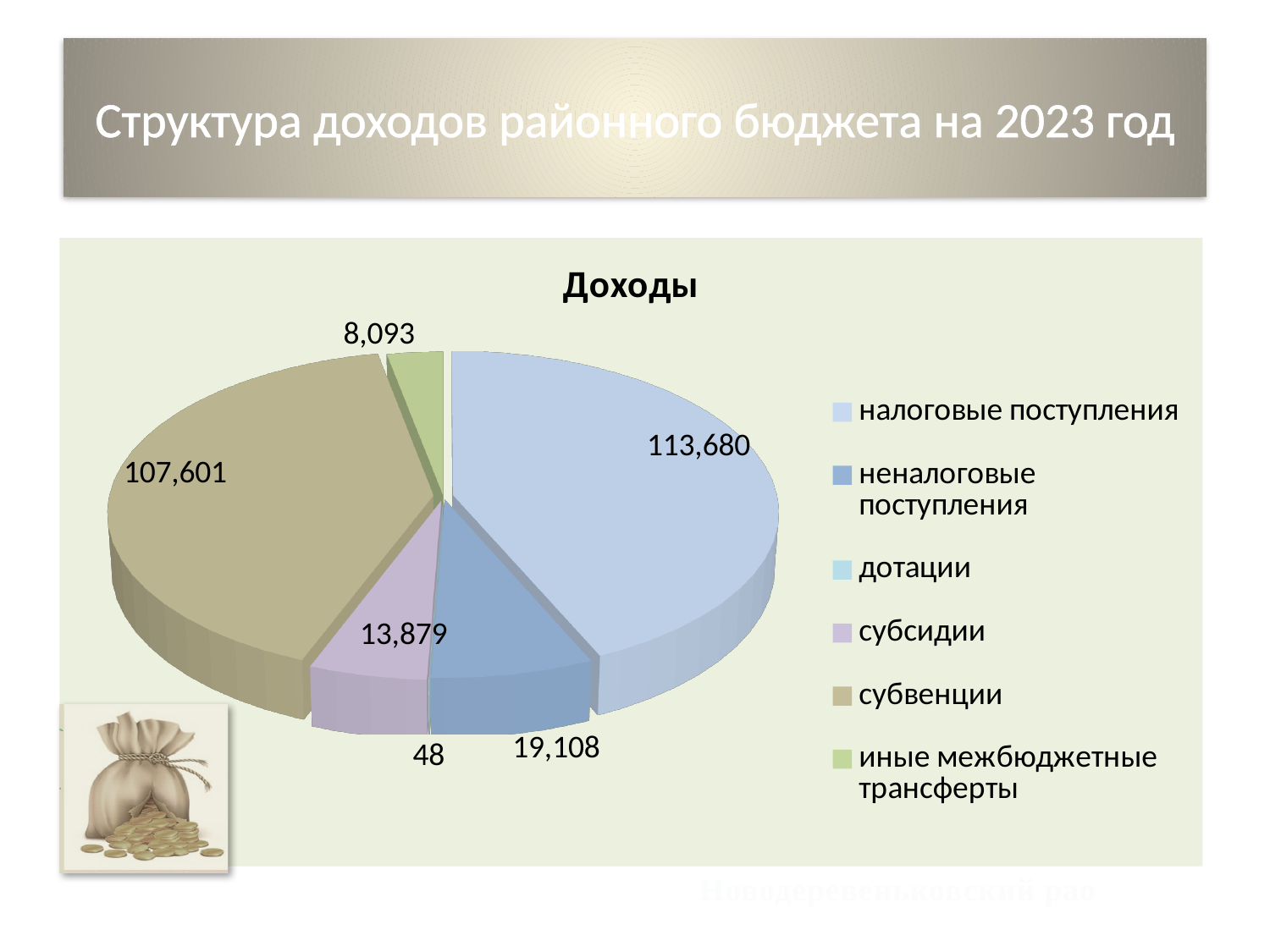
What is the value for налоговые поступления? 113,680 What is the title of the chart? Доходы What is the value for иные межбюджетные трансферты? 8,093 How many categories does the legend of the chart list? 6 What is the value for неналоговые поступления? 19,108 Which is larger, the value for неналоговые поступления or the value for субсидии? неналоговые поступления Which category has the largest value in the chart? налоговые поступления What is the difference between the values for налоговые поступления and субвенции? 6,079 Which category has the smallest value in the chart? дотации What is the value for дотации? 48 What is the value for субвенции? 107,601 What type of chart is shown on the slide? pie chart